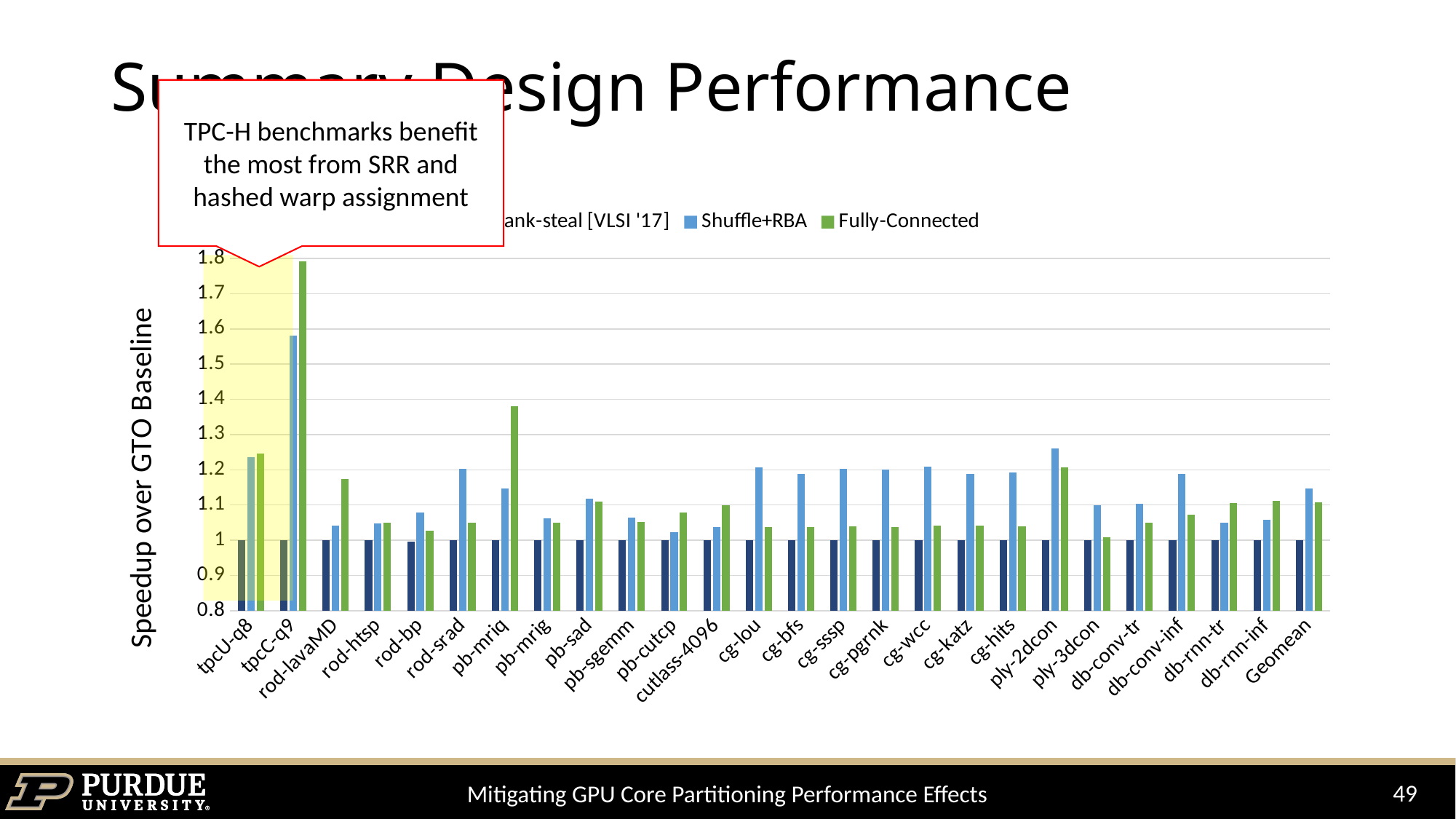
What is the title of the y axis of the chart? Speedup over GTO Baseline What kind of chart is shown on the slide? bar chart How many benchmark categories are plotted along the x axis of the chart? 26 For which benchmark is the Shuffle+RBA speedup the highest? tpcC-q9 For pb-mriq, which is larger: the Shuffle+RBA value or the Fully-Connected value? Fully-Connected For which benchmark is the Fully-Connected speedup the highest? tpcC-q9 Is the Fully-Connected value for cg-lou greater or less than 1.1? less Is the Shuffle+RBA value for tpcC-q9 greater or less than 1.5? greater Is the Fully-Connected value for tpcC-q9 greater or less than 1.7? greater For cg-bfs, which is larger: the Shuffle+RBA value or the Fully-Connected value? Shuffle+RBA How many series are plotted for each benchmark in the chart? 3